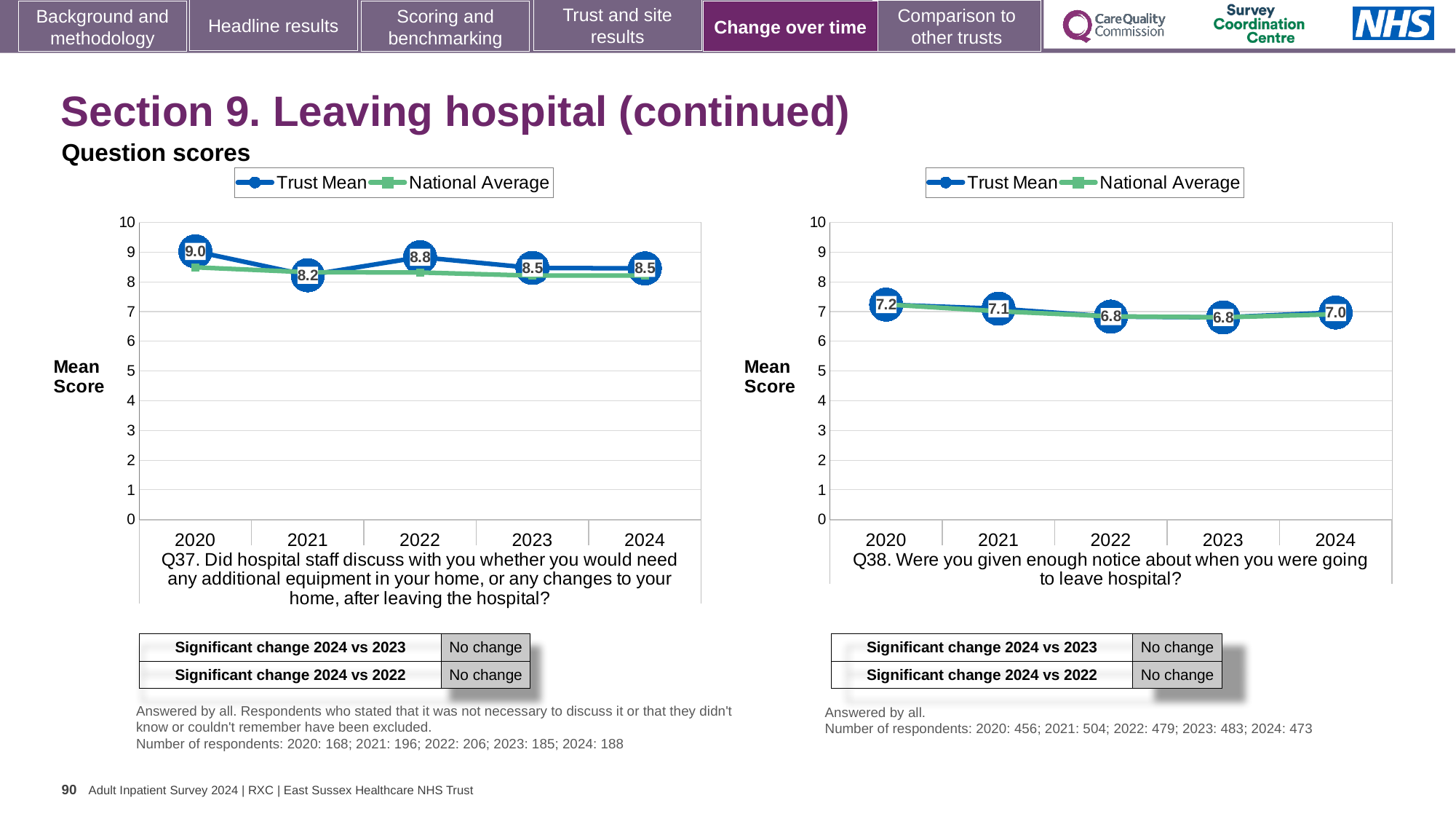
How many series does the legend of the Q38 chart (right) list? 2 On the Q37 chart (left), which year has the highest Trust Mean score? 2020 On the Q38 chart (right), which year has the highest Trust Mean score? 2020 On the Q37 chart (left), what is the Trust Mean score for 2021? 8.2 On the Q38 chart (right), is the Trust Mean score for 2020 larger than the Trust Mean score for 2022? Yes On the Q38 chart (right), what is the Trust Mean score for 2024? 7.0 How many years are plotted on the Q37 chart (left)? 5 What type of chart is the Q37 chart (left)? Line chart On the Q37 chart (left), which year has the lowest Trust Mean score? 2021 On the Q38 chart (right), is the Trust Mean score for 2022 greater or less than 7? less On the Q37 chart (left), what is the difference between the Trust Mean scores for 2020 and 2021? 0.8 On the Q37 chart (left), what is the Trust Mean score for 2020? 9.0